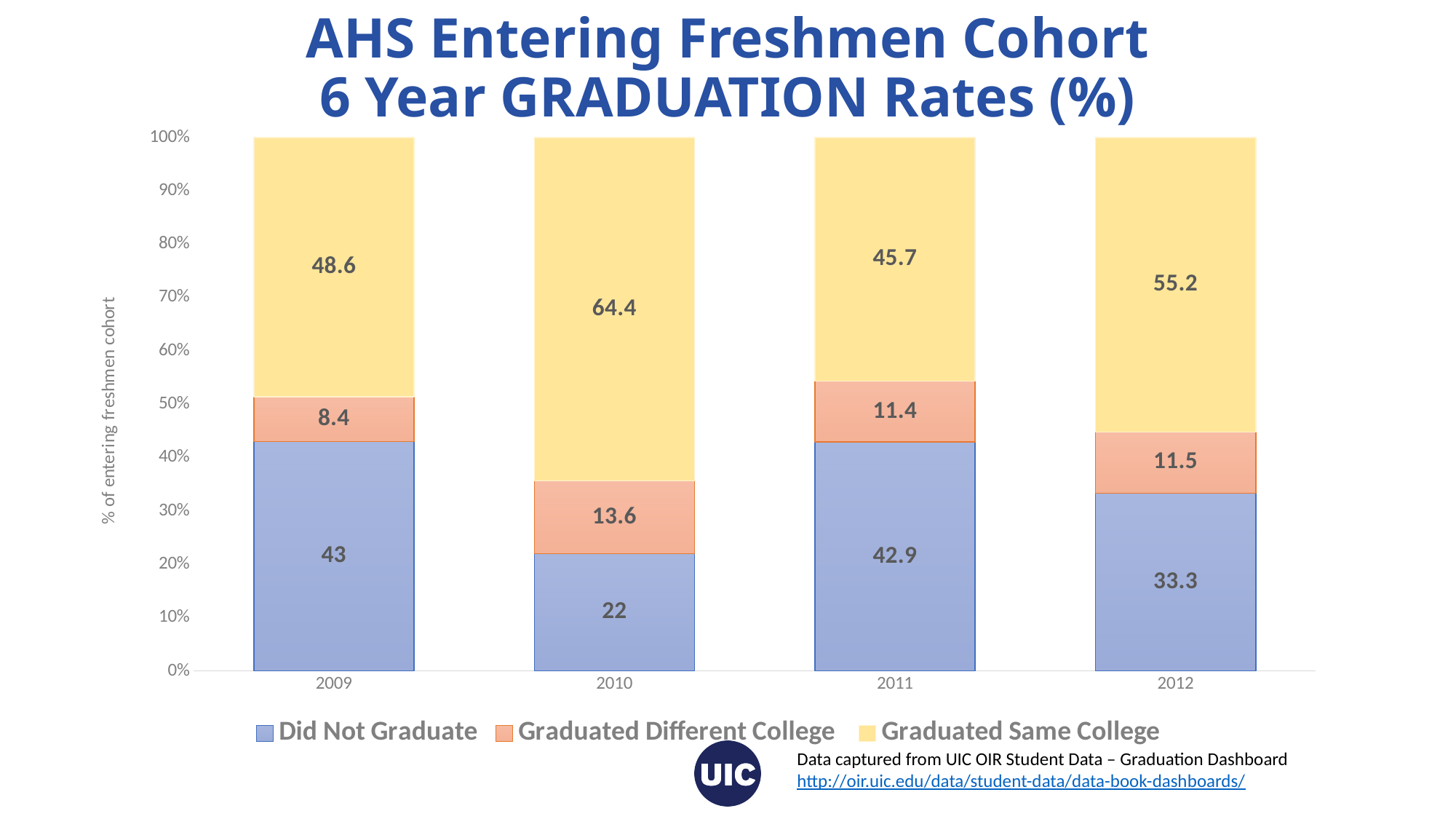
What is the value for Graduated Same College in 2012? 55.2 What is the total of the Did Not Graduate and Graduated Different College segments for 2009? 51.4 Which year has the lowest value for Did Not Graduate? 2010 How many years are shown on the x axis? 4 Is the Did Not Graduate value for 2011 greater or less than 40%? greater What kind of chart is shown on the slide? Stacked bar chart What is the difference between the Graduated Same College values for 2010 and 2011? 18.7 How many series does the legend list? 3 Which year has the highest value for Graduated Same College? 2010 What is the value for Graduated Different College in 2011? 11.4 What is the value for Did Not Graduate in 2010? 22 Which is larger, the Did Not Graduate value for 2009 or for 2012? 2009